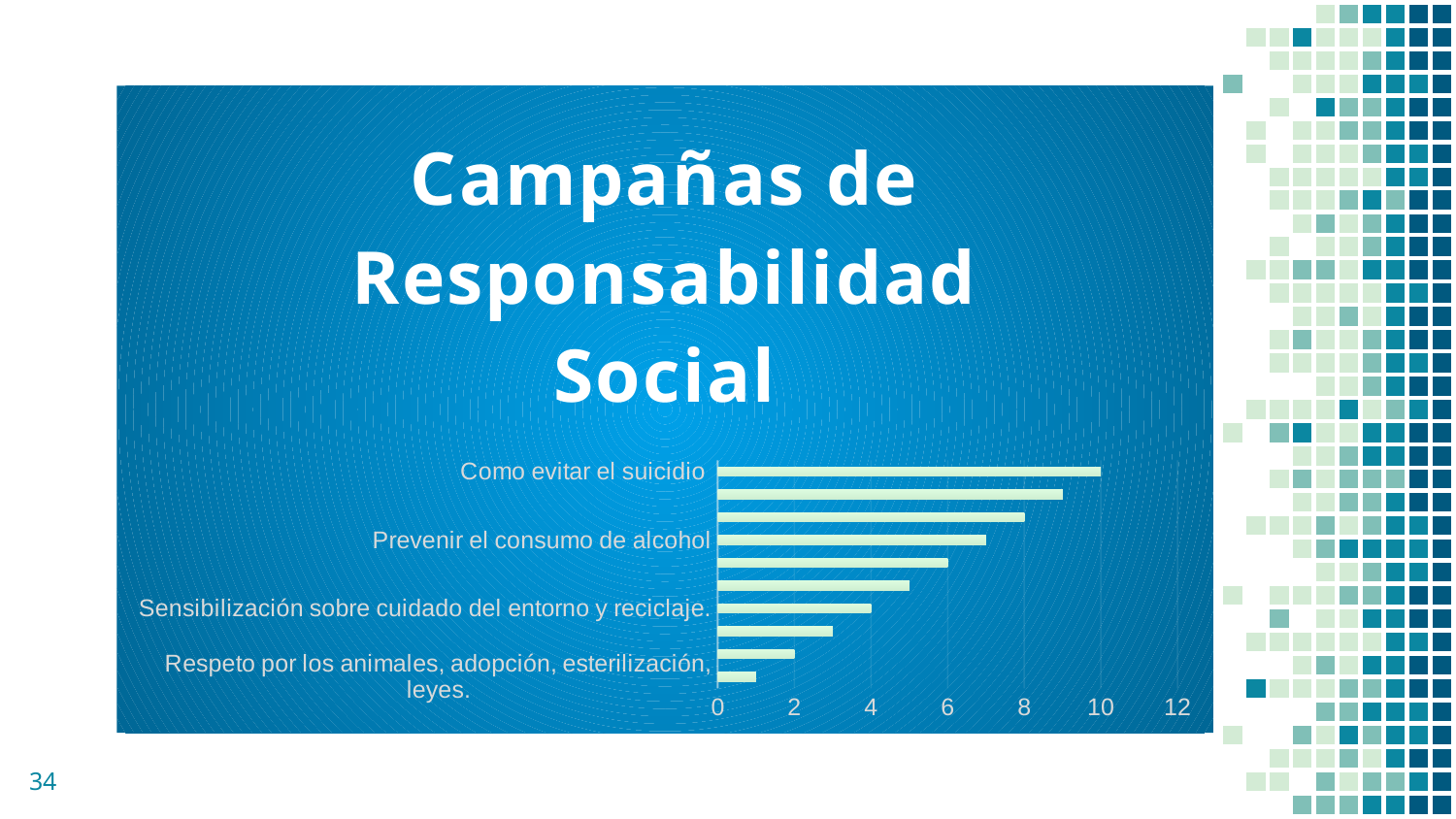
Is the value for 'Prevenir el consumo de alcohol' greater or less than 6? greater Is the value for 'Respeto por los animales, adopción, esterilización, leyes.' greater or less than 2? less What is the highest value shown on the horizontal axis? 12 What is the value for 'Sensibilización sobre cuidado del entorno y reciclaje.'? 4 Which category has the shortest bar? Respeto por los animales, adopción, esterilización, leyes. Which is larger, the value for 'Como evitar el suicidio' or the value for 'Prevenir el consumo de alcohol'? Como evitar el suicidio Is the value for 'Prevenir el consumo de alcohol' greater or less than 8? less What is the value for 'Como evitar el suicidio'? 10 Which category has the longest bar? Como evitar el suicidio What kind of chart is shown on the slide? bar chart What is the title shown above the chart? Campañas de Responsabilidad Social How many bars does the chart contain? 10